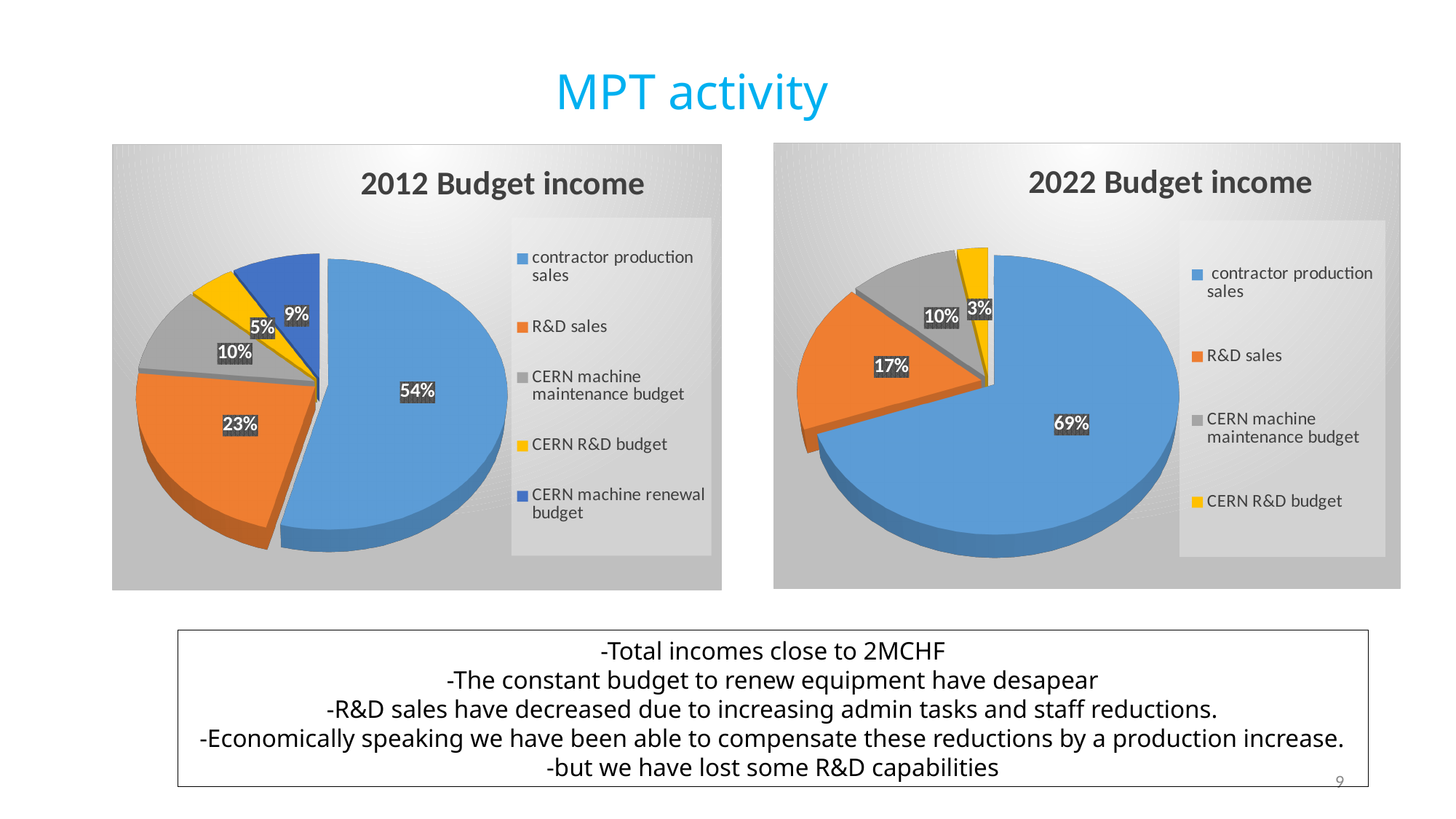
In the 2022 Budget income chart, what share does contractor production sales have? 69% In the 2012 Budget income chart, what share does contractor production sales have? 54% What type of chart is the 2022 Budget income chart? pie chart How many categories does the legend of the 2022 Budget income chart list? 4 In the 2022 Budget income chart, which category has the largest slice? contractor production sales In the 2012 Budget income chart, what share does the CERN machine renewal budget have? 9% In the 2022 Budget income chart, which category has the smallest slice? CERN R&D budget In the 2012 Budget income chart, what share does R&D sales have? 23% In the 2022 Budget income chart, what share does the CERN R&D budget have? 3% What is the difference between the R&D sales share in the 2012 Budget income chart and in the 2022 Budget income chart? 6% In the 2012 Budget income chart, which category has the smallest slice? CERN R&D budget How many categories does the legend of the 2012 Budget income chart list? 5